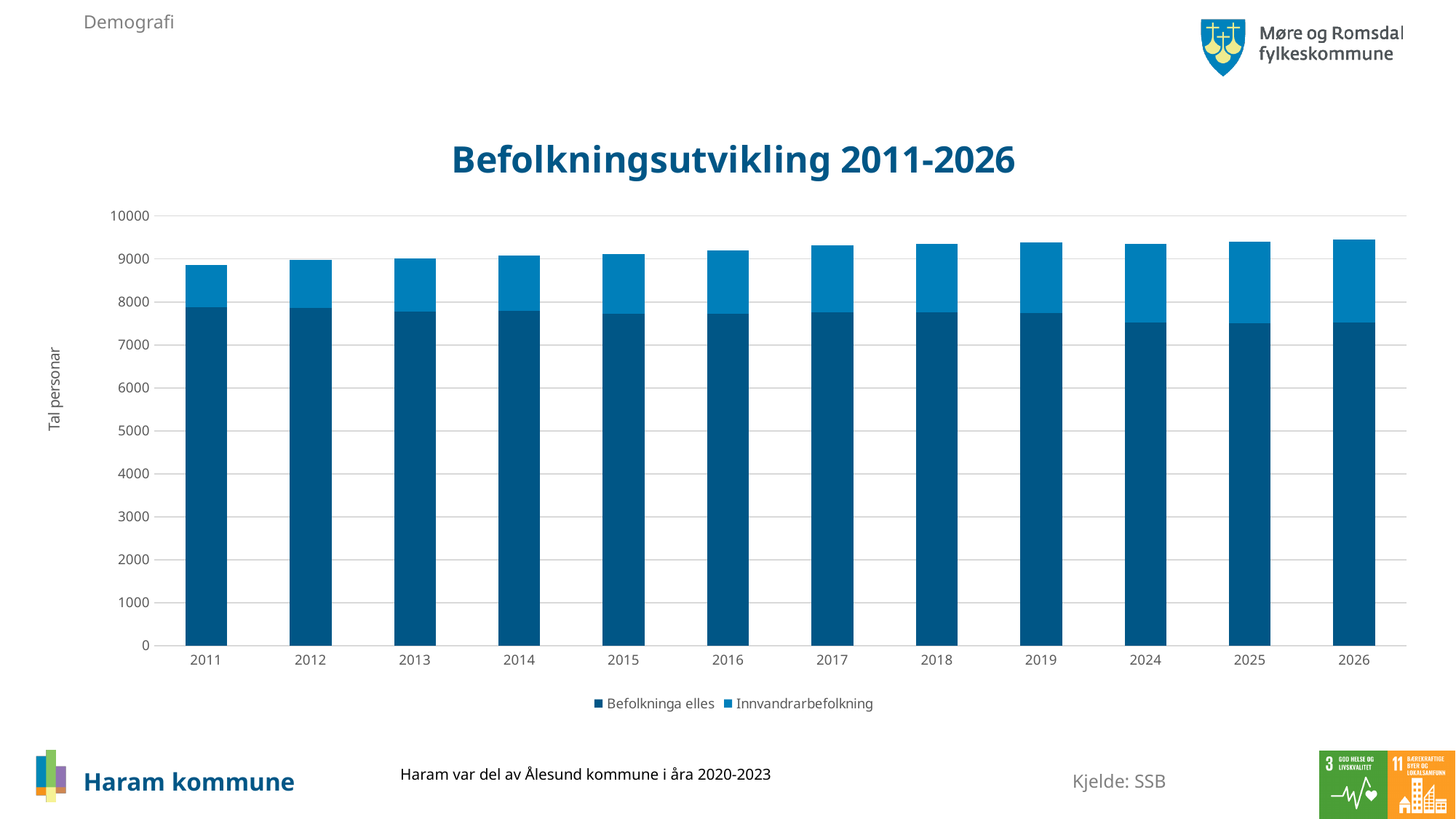
Is the Innvandrarbefolkning segment larger in 2011 or in 2026? 2026 How many years are shown on the x axis? 12 Is the value of Befolkninga elles for 2011 greater or less than 8000? less Is the total population (full stacked bar) for 2011 greater or less than 9000? less What is the title of the chart? Befolkningsutvikling 2011-2026 Is the value of Befolkninga elles for 2026 greater or less than 7000? greater How many series does the legend list? 2 Which year has the lowest total population (shortest stacked bar)? 2011 What kind of chart is shown on the slide? Stacked bar chart Which series is shown in the darker blue colour? Befolkninga elles Does the total population generally rise or fall from 2011 to 2026? rise